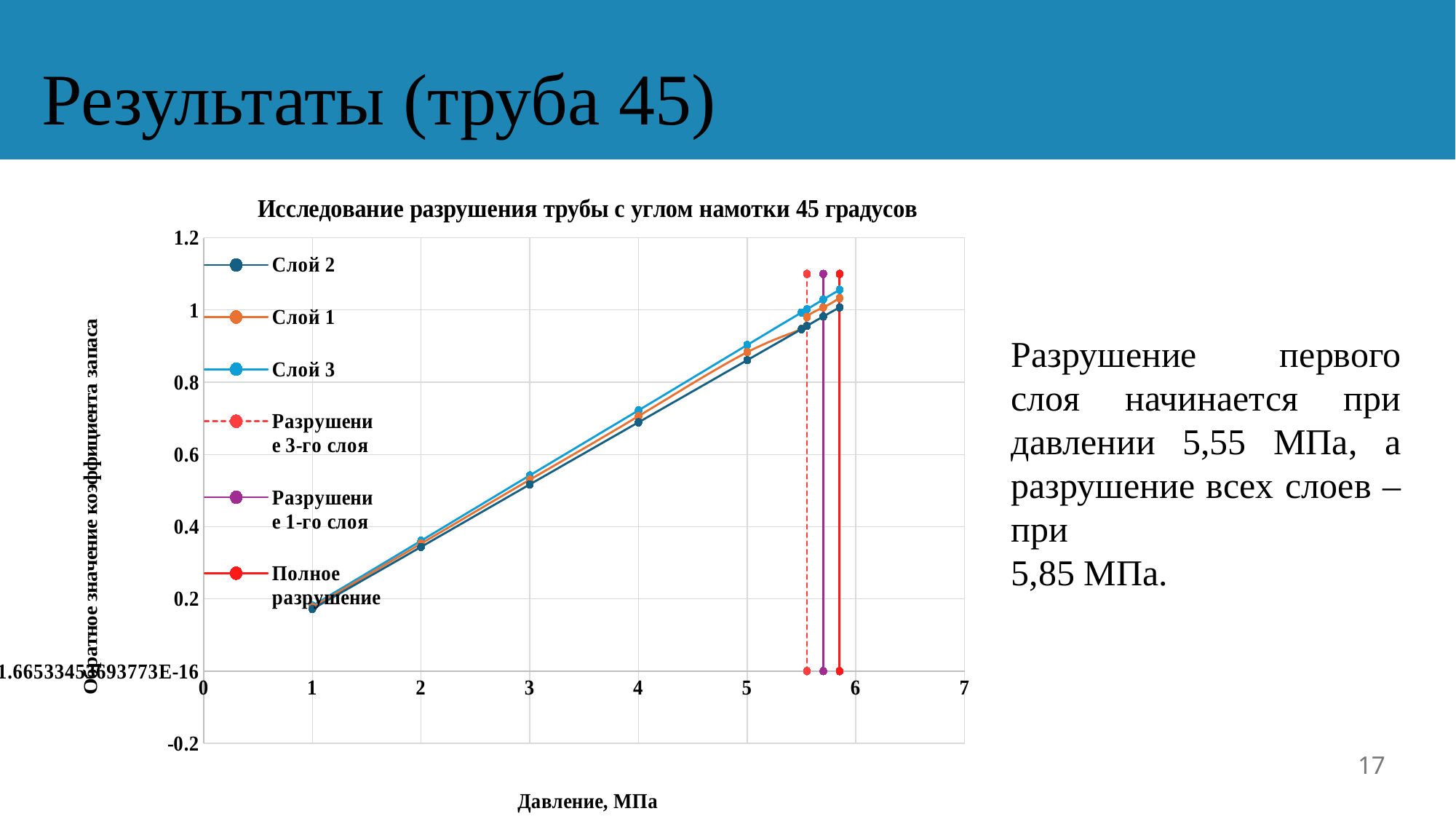
How many series does the chart legend list? 6 At a pressure of 5 МПа, which has the larger value: Слой 3 or Слой 2? Слой 3 Is the value for Слой 1 at a pressure of 2 МПа greater or less than 0.4? less Is the value for Слой 2 at a pressure of 3 МПа greater or less than 0.4? greater Is the value for Слой 2 at a pressure of 4 МПа greater or less than 0.8? less What kind of chart is shown on the slide? line chart What is the title of the chart? Исследование разрушения трубы с углом намотки 45 градусов What is the label of the x axis of the chart? Давление, МПа Do the values for Слой 3 rise or fall as pressure increases along the x axis? rise